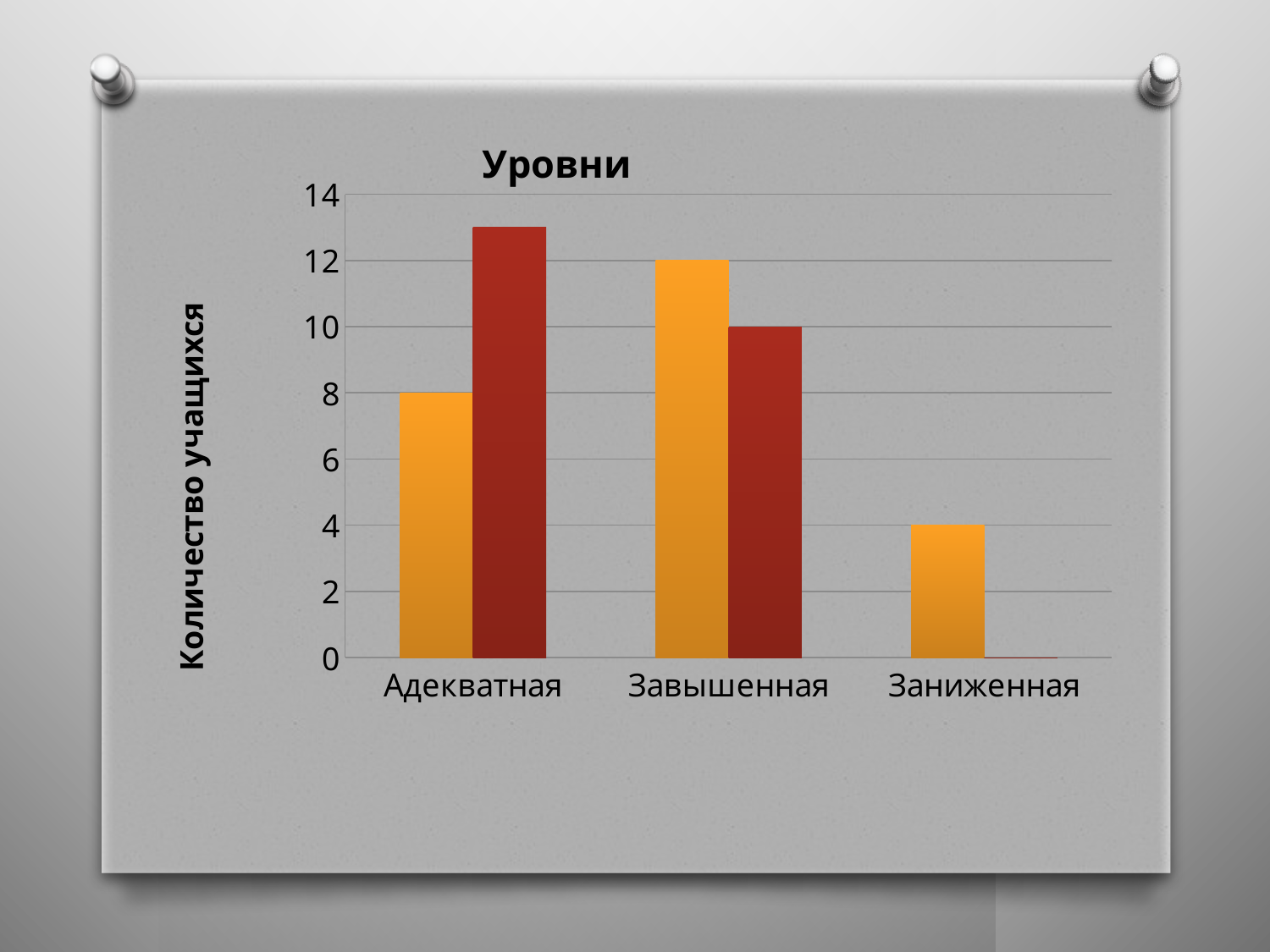
For Адекватная, which bar is taller, the orange one or the red one? the red one What is the value of the red bar for Завышенная? 10 What is the label on the vertical axis of the chart? Количество учащихся How many categories are shown on the x axis of the chart? 3 What is the value of the orange bar for Завышенная? 12 Is the value of the red bar for Адекватная greater or less than 12? greater What is the value of the orange bar for Заниженная? 4 Among the orange bars, which category has the lowest value? Заниженная What is the value of the orange bar for Адекватная? 8 What kind of chart is shown on the slide? bar chart Among the orange bars, which category has the highest value? Завышенная What is the title of the chart? Уровни